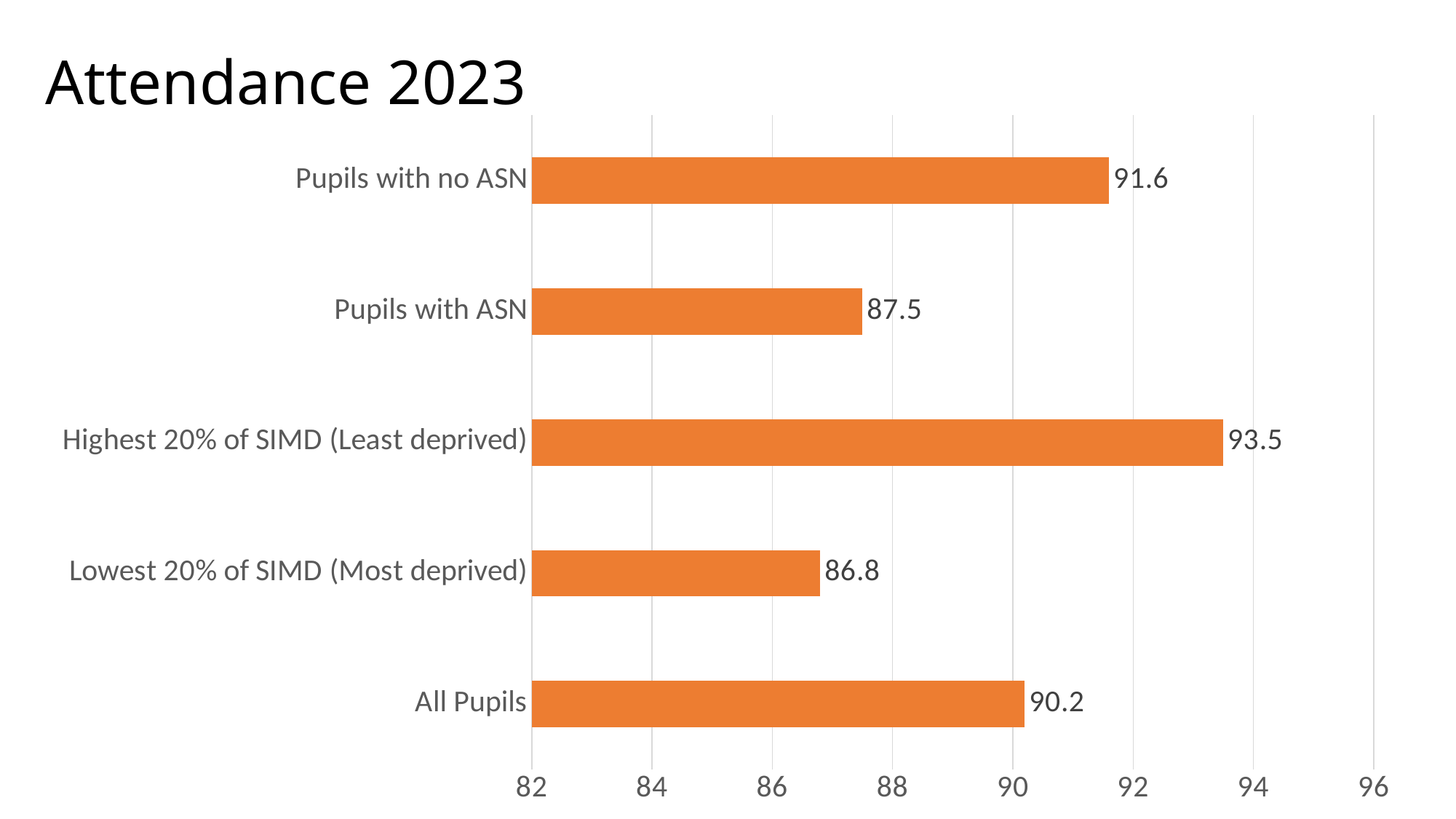
Is the value for Pupils with ASN greater or less than 88? less What is the attendance value for Lowest 20% of SIMD (Most deprived)? 86.8 What is the difference between the attendance values for Highest 20% of SIMD (Least deprived) and Lowest 20% of SIMD (Most deprived)? 6.7 What is the difference between the attendance values for Pupils with no ASN and Pupils with ASN? 4.1 Which category has the highest attendance value? Highest 20% of SIMD (Least deprived) Which category has the lowest attendance value? Lowest 20% of SIMD (Most deprived) What is the attendance value for Pupils with no ASN? 91.6 What type of chart is shown on the slide? Bar chart Which has a higher attendance value, All Pupils or Pupils with ASN? All Pupils What is the attendance value for Pupils with ASN? 87.5 What is the attendance value for All Pupils? 90.2 How many categories are shown in the chart? 5